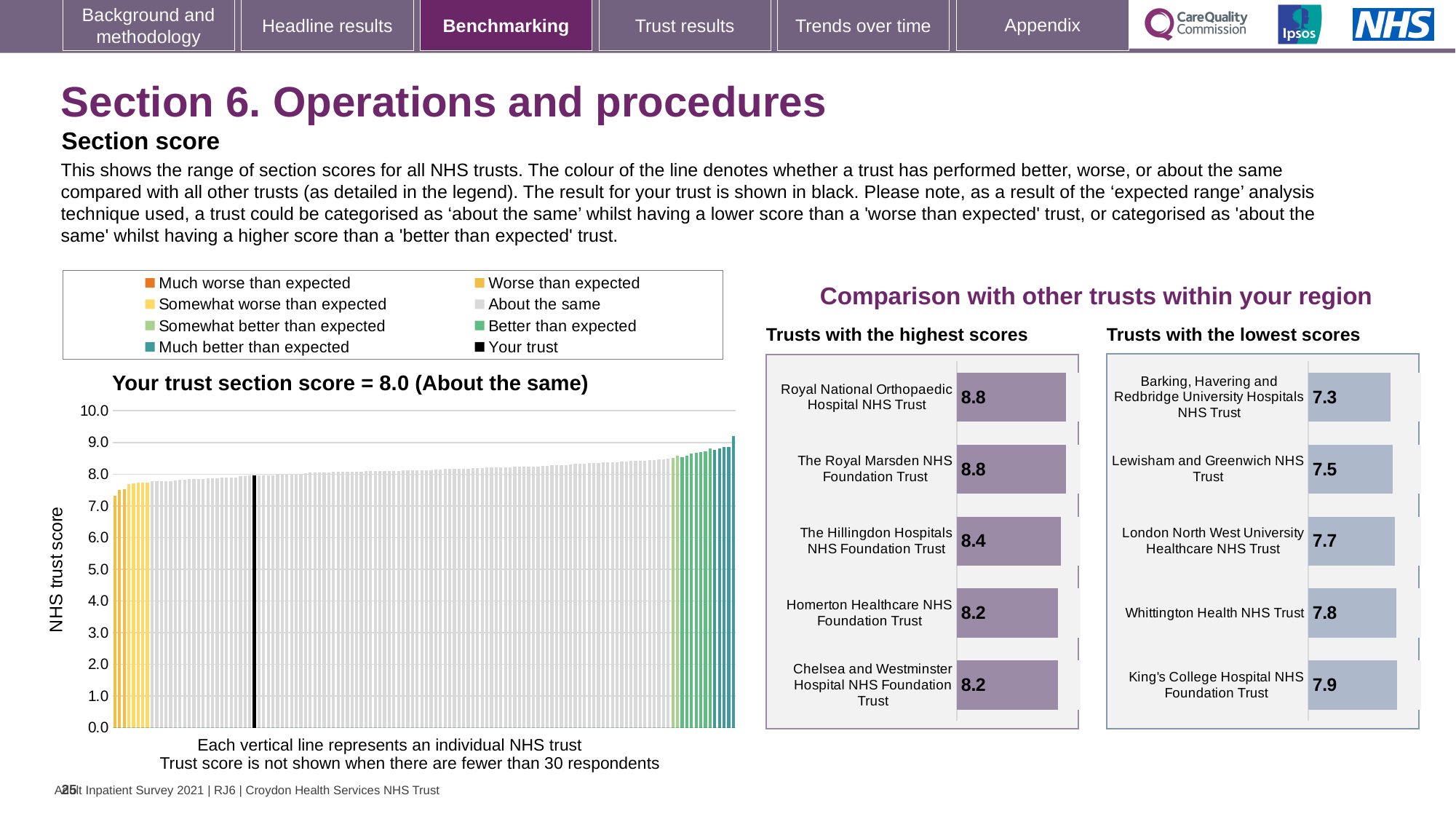
What kind of chart is the 'Your trust section score' chart on the left? Bar chart In the 'Trusts with the lowest scores' chart, which has the larger score: Lewisham and Greenwich NHS Trust or Whittington Health NHS Trust? Whittington Health NHS Trust How many trusts are listed in the 'Trusts with the highest scores' chart? 5 In the 'Trusts with the lowest scores' chart, what is the score for Barking, Havering and Redbridge University Hospitals NHS Trust? 7.3 In the 'Trusts with the lowest scores' chart, which trust has the highest score? King's College Hospital NHS Foundation Trust In the 'Trusts with the highest scores' chart, what is the difference between the scores of Royal National Orthopaedic Hospital NHS Trust and Chelsea and Westminster Hospital NHS Foundation Trust? 0.6 In the 'Trusts with the highest scores' chart, what is the score for The Hillingdon Hospitals NHS Foundation Trust? 8.4 How many entries does the legend above the left chart list? 8 According to the title of the left chart, what is your trust's section score? 8.0 (About the same) In the 'Trusts with the lowest scores' chart, which trust has the lowest score? Barking, Havering and Redbridge University Hospitals NHS Trust In the left chart, do the trust scores rise or fall from left to right? Rise In the left chart, is the value of the black 'Your trust' bar greater or less than 5.0? greater